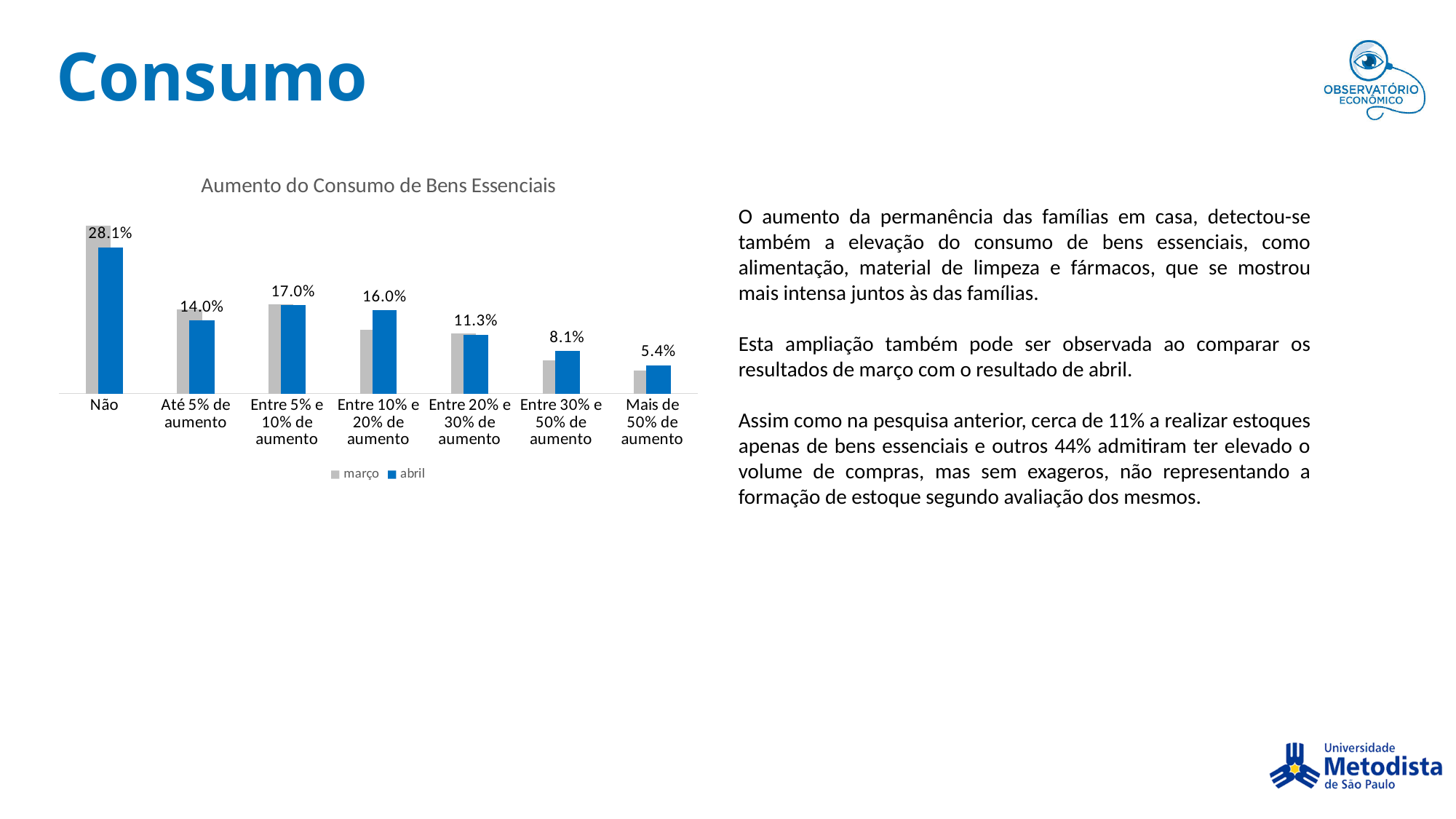
What kind of chart is shown on the slide? bar chart What data label is shown for the category 'Entre 5% e 10% de aumento'? 17.0% What is the difference between the labelled values for 'Não' and 'Mais de 50% de aumento'? 22.7 percentage points How many categories are shown on the x axis of the chart? 7 What is the title of the chart? Aumento do Consumo de Bens Essenciais Which category has the lowest labelled value? Mais de 50% de aumento How many series does the chart legend list? 2 What data label is shown for the category 'Mais de 50% de aumento'? 5.4% What data label is shown for the category 'Não'? 28.1% For the category 'Não', which series has the taller bar, março or abril? março Which category has the highest labelled value? Não What data label is shown for the category 'Entre 20% e 30% de aumento'? 11.3%